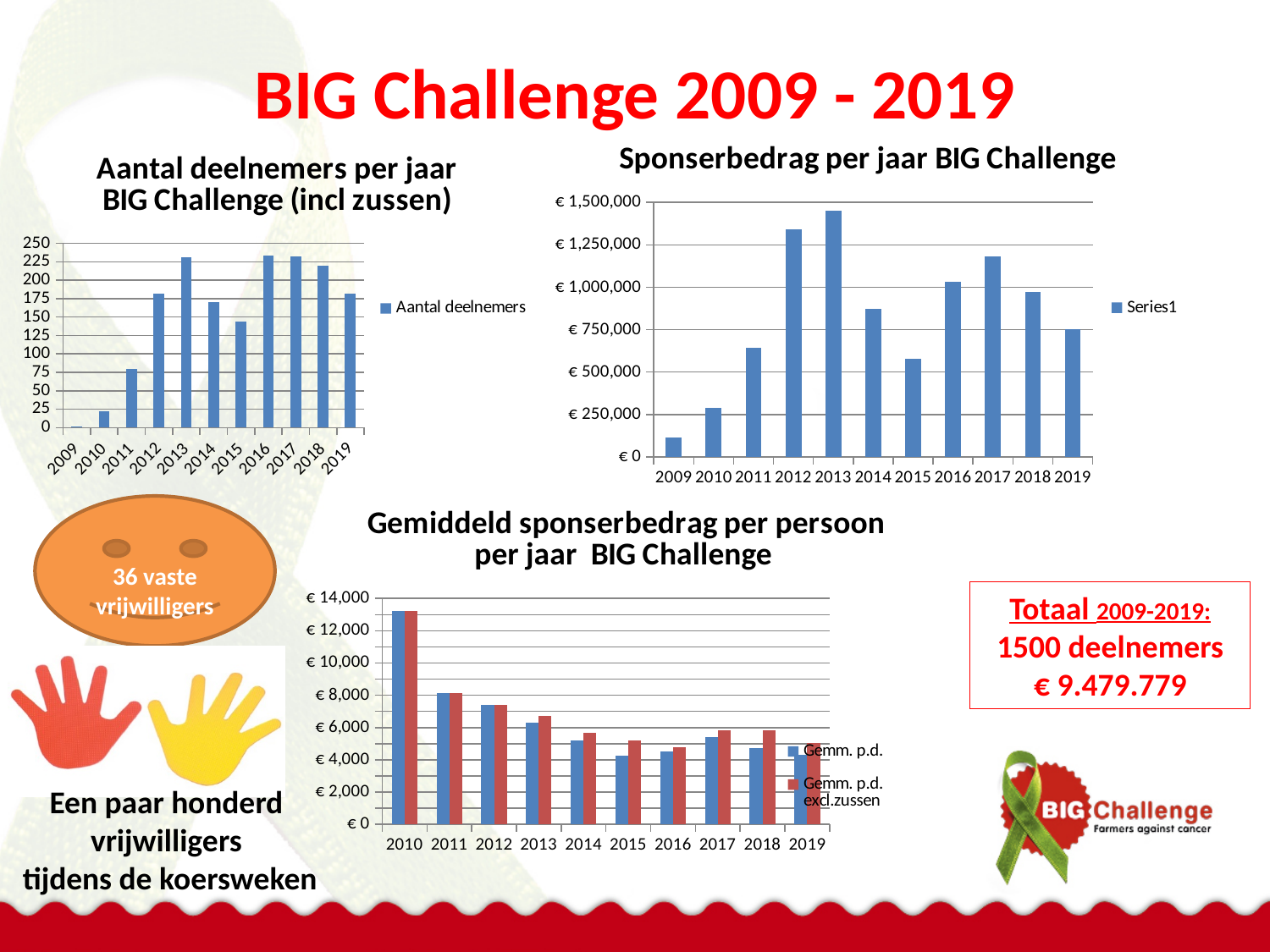
How many years are shown on the x axis of the chart 'Sponserbedrag per jaar BIG Challenge'? 11 In the chart 'Aantal deelnemers per jaar BIG Challenge (incl zussen)', which is larger, the value for 2013 or the value for 2014? 2013 What kind of chart is 'Gemiddeld sponserbedrag per persoon per jaar BIG Challenge'? bar chart In the chart 'Sponserbedrag per jaar BIG Challenge', which year has the lowest sponsorship amount? 2009 In the chart 'Sponserbedrag per jaar BIG Challenge', is the value for 2015 greater or less than € 750,000? less How many series does the legend list in the chart 'Gemiddeld sponserbedrag per persoon per jaar BIG Challenge'? 2 In the chart 'Sponserbedrag per jaar BIG Challenge', is the value for 2012 greater or less than € 1,250,000? greater In the chart 'Sponserbedrag per jaar BIG Challenge', which year has the highest sponsorship amount? 2013 In the chart 'Gemiddeld sponserbedrag per persoon per jaar BIG Challenge', which year has the highest average sponsorship per person? 2010 In the chart 'Sponserbedrag per jaar BIG Challenge', which is larger, the value for 2017 or the value for 2018? 2017 In the chart 'Aantal deelnemers per jaar BIG Challenge (incl zussen)', which year has the lowest number of participants? 2009